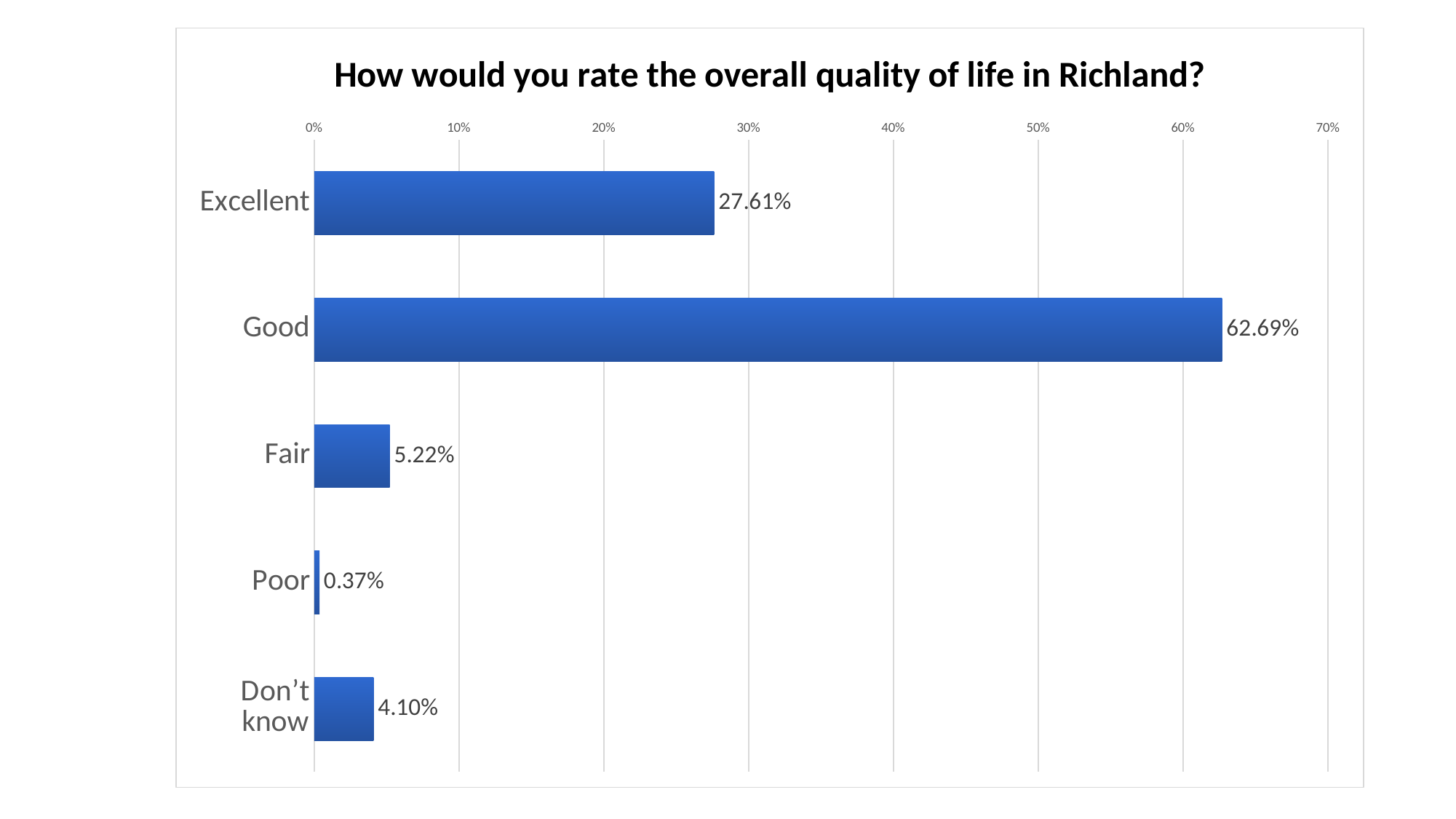
What percentage of respondents rated the overall quality of life in Richland as Fair? 5.22% What kind of chart is shown on the slide? Bar chart Which rating category has the highest percentage? Good Which rating category has the lowest percentage? Poor What percentage of respondents rated the overall quality of life in Richland as Poor? 0.37% What is the difference in percentage points between the Good and Excellent ratings? 35.08% What is the title of the chart? How would you rate the overall quality of life in Richland? How many rating categories are shown in the chart? 5 What percentage of respondents rated the overall quality of life in Richland as Excellent? 27.61% Which has a larger percentage, Fair or Don't know? Fair What percentage of respondents rated the overall quality of life in Richland as Good? 62.69% What percentage of respondents answered Don't know? 4.10%